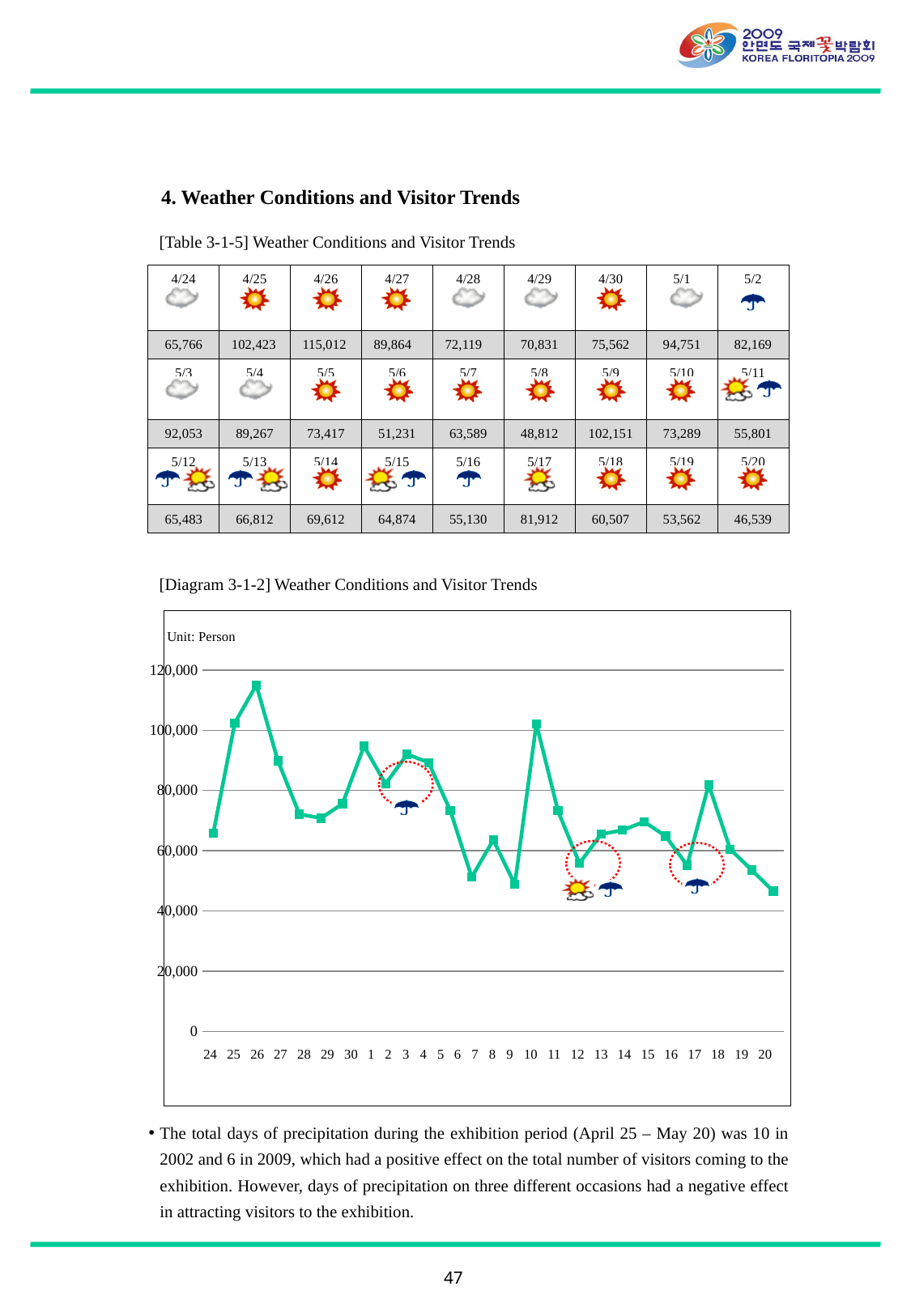
Which date had the highest number of visitors? 4/26 What unit is stated for the values in the line chart? Person Which date had the lowest number of visitors? 5/20 How many data points are plotted on the line chart? 27 How many visitors came on 4/26? 115,012 Which had more visitors, 5/9 or 5/10? 5/9 How many visitors came on 5/9? 102,151 Is the value for 20 on the line chart greater or less than 60,000? less Is the value for 26 on the line chart greater or less than 100,000? greater What is the difference in visitors between 4/26 and 4/25? 12,589 What is the highest value shown on the y axis of the line chart? 120,000 What kind of chart is shown in Diagram 3-1-2? line chart